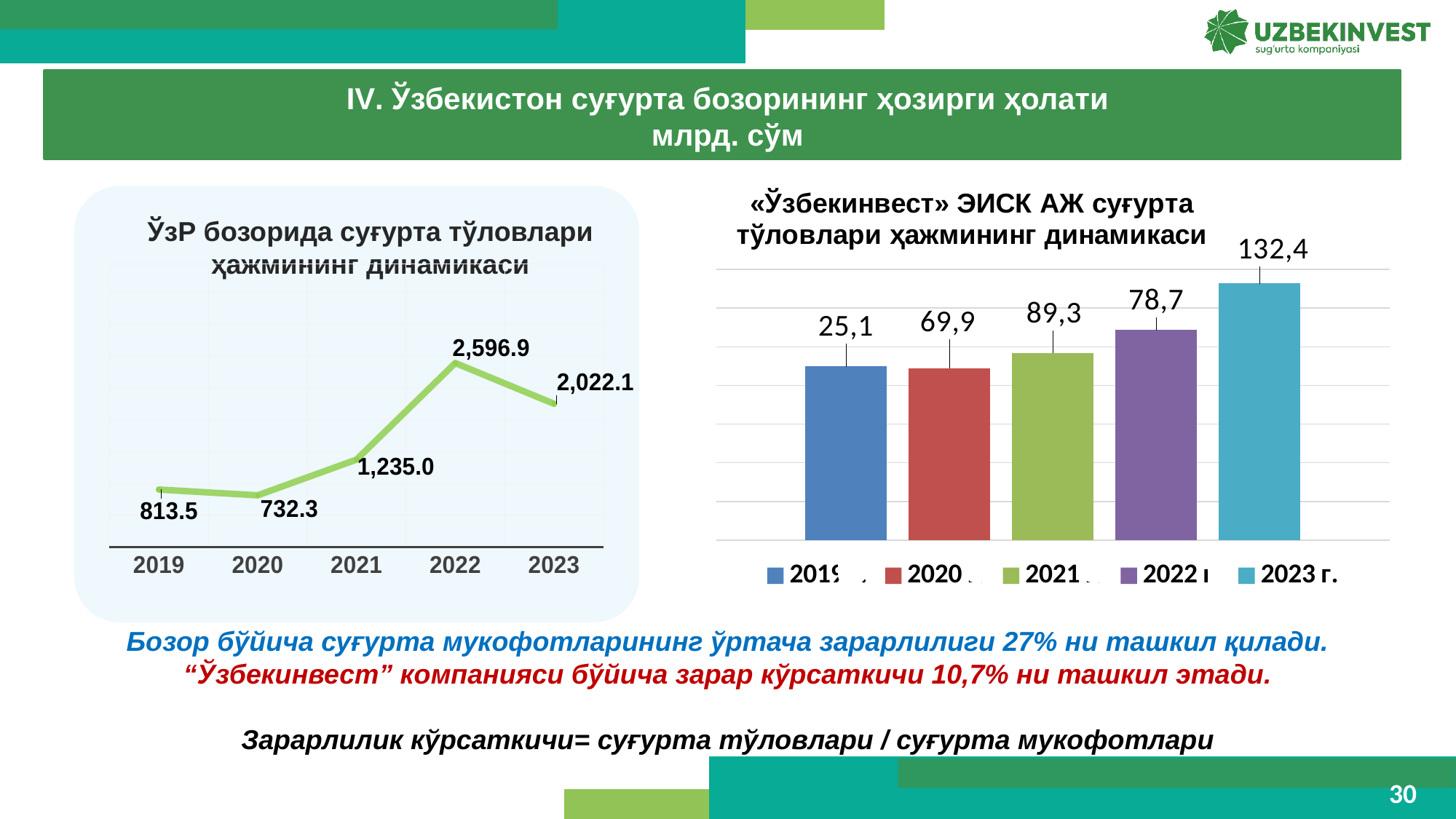
In the right chart («Ўзбекинвест» ЭИСК АЖ суғурта тўловлари ҳажмининг динамикаси), what is the difference between the 2023 and 2019 values? 107,3 In the left chart (ЎзР бозорида суғурта тўловлари ҳажмининг динамикаси), what is the value for 2020? 732.3 How many entries does the legend of the right chart («Ўзбекинвест» ЭИСК АЖ суғурта тўловлари ҳажмининг динамикаси) list? 5 In the right chart («Ўзбекинвест» ЭИСК АЖ суғурта тўловлари ҳажмининг динамикаси), which is larger, the value for 2021 or the value for 2022? 2021 What kind of chart is the left chart (ЎзР бозорида суғурта тўловлари ҳажмининг динамикаси)? Line chart In the left chart (ЎзР бозорида суғурта тўловлари ҳажмининг динамикаси), how many years are plotted? 5 In the right chart («Ўзбекинвест» ЭИСК АЖ суғурта тўловлари ҳажмининг динамикаси), what is the value for 2021? 89,3 In the right chart («Ўзбекинвест» ЭИСК АЖ суғурта тўловлари ҳажмининг динамикаси), which year has the highest value? 2023 In the left chart (ЎзР бозорида суғурта тўловлари ҳажмининг динамикаси), what is the value for 2022? 2,596.9 What kind of chart is the right chart («Ўзбекинвест» ЭИСК АЖ суғурта тўловлари ҳажмининг динамикаси)? Bar chart In the left chart (ЎзР бозорида суғурта тўловлари ҳажмининг динамикаси), which year has the lowest value? 2020 In the left chart (ЎзР бозорида суғурта тўловлари ҳажмининг динамикаси), what is the difference between the 2022 and 2023 values? 574.8